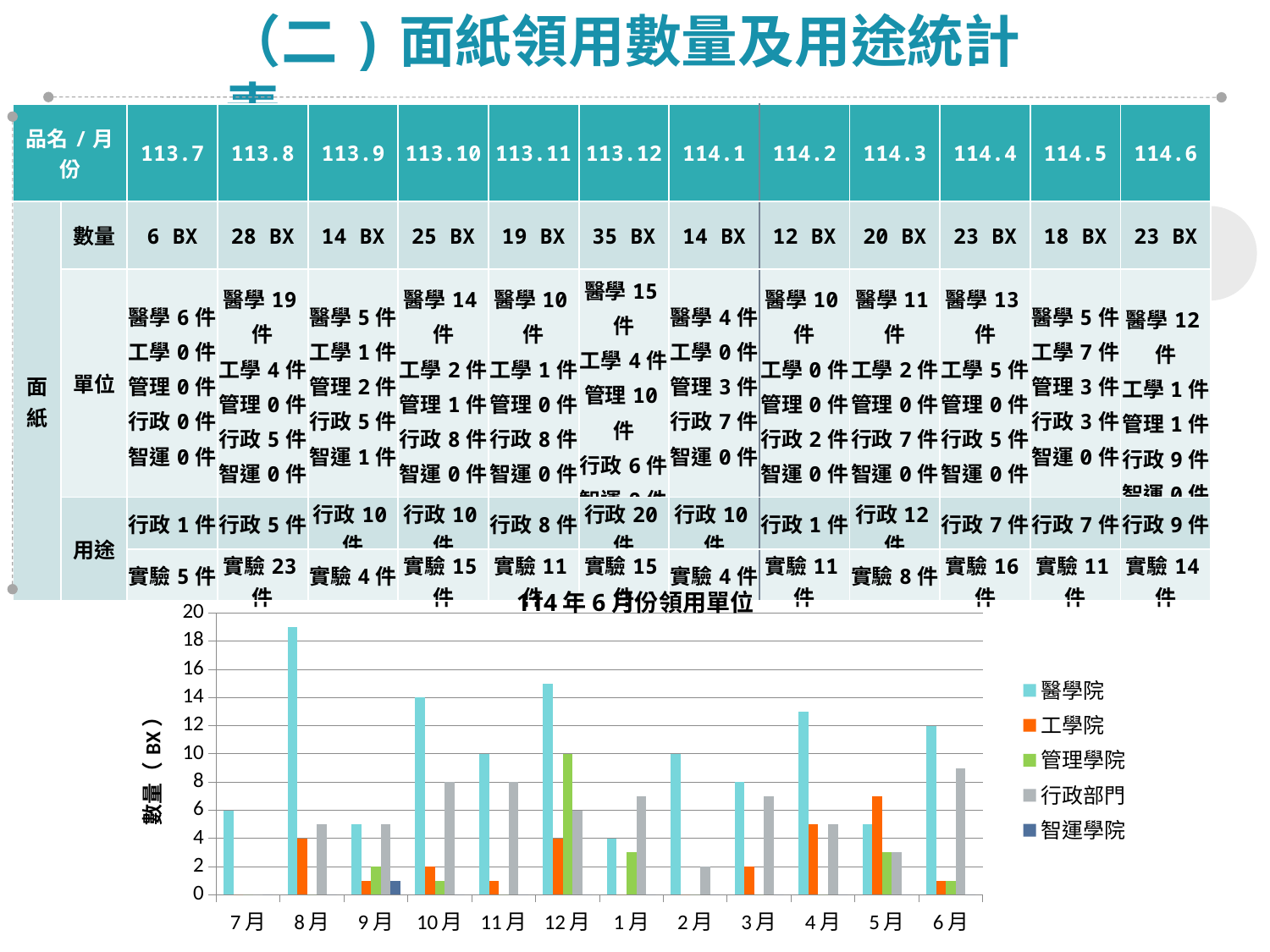
How many months are shown along the x axis of the bar chart? 12 What kind of chart is shown at the bottom of the slide? bar chart In the bar chart, what is the value for 醫學院 in 10月? 14 In the bar chart, what is the value for 醫學院 in 7月? 6 How many series does the legend of the bar chart list? 5 In the bar chart, is the value for 醫學院 in 8月 greater or less than 18? greater In the bar chart, what is the value for 管理學院 in 12月? 10 In the bar chart, which month has the highest value for 醫學院? 8月 In the bar chart, what is the value for 行政部門 in 12月? 6 What is the title of the bar chart? 114年6月份領用單位 In the bar chart, which is larger in 10月: 醫學院 or 行政部門? 醫學院 In the bar chart, what is the difference between 醫學院 and 行政部門 in 11月? 2